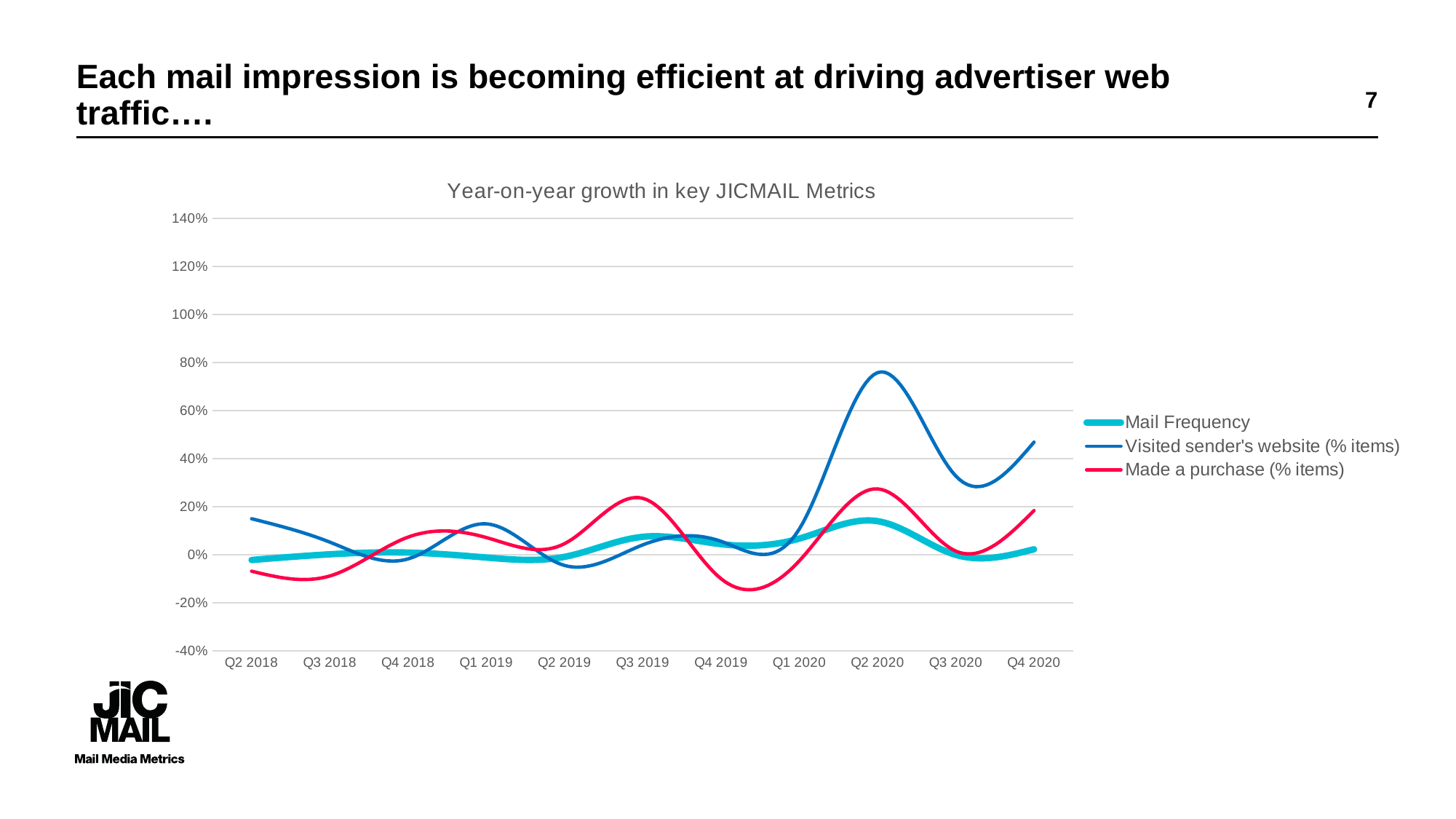
In Q2 2018, which series has the higher value: Visited sender's website (% items) or Made a purchase (% items)? Visited sender's website (% items) What is the title of the chart? Year-on-year growth in key JICMAIL Metrics Is the value for Visited sender's website (% items) in Q2 2020 greater or less than 60%? greater How many series does the legend list? 3 How many quarters are shown on the x axis? 11 In which quarter does the Visited sender's website (% items) series reach its highest value? Q2 2020 Is the value for Visited sender's website (% items) in Q4 2020 greater or less than 40%? greater What kind of chart is shown on the slide? line chart In Q2 2020, which series has the higher value: Visited sender's website (% items) or Made a purchase (% items)? Visited sender's website (% items) Is the value for Made a purchase (% items) in Q4 2019 greater or less than 0%? less Does the Visited sender's website (% items) series rise or fall from Q3 2020 to Q4 2020? rise